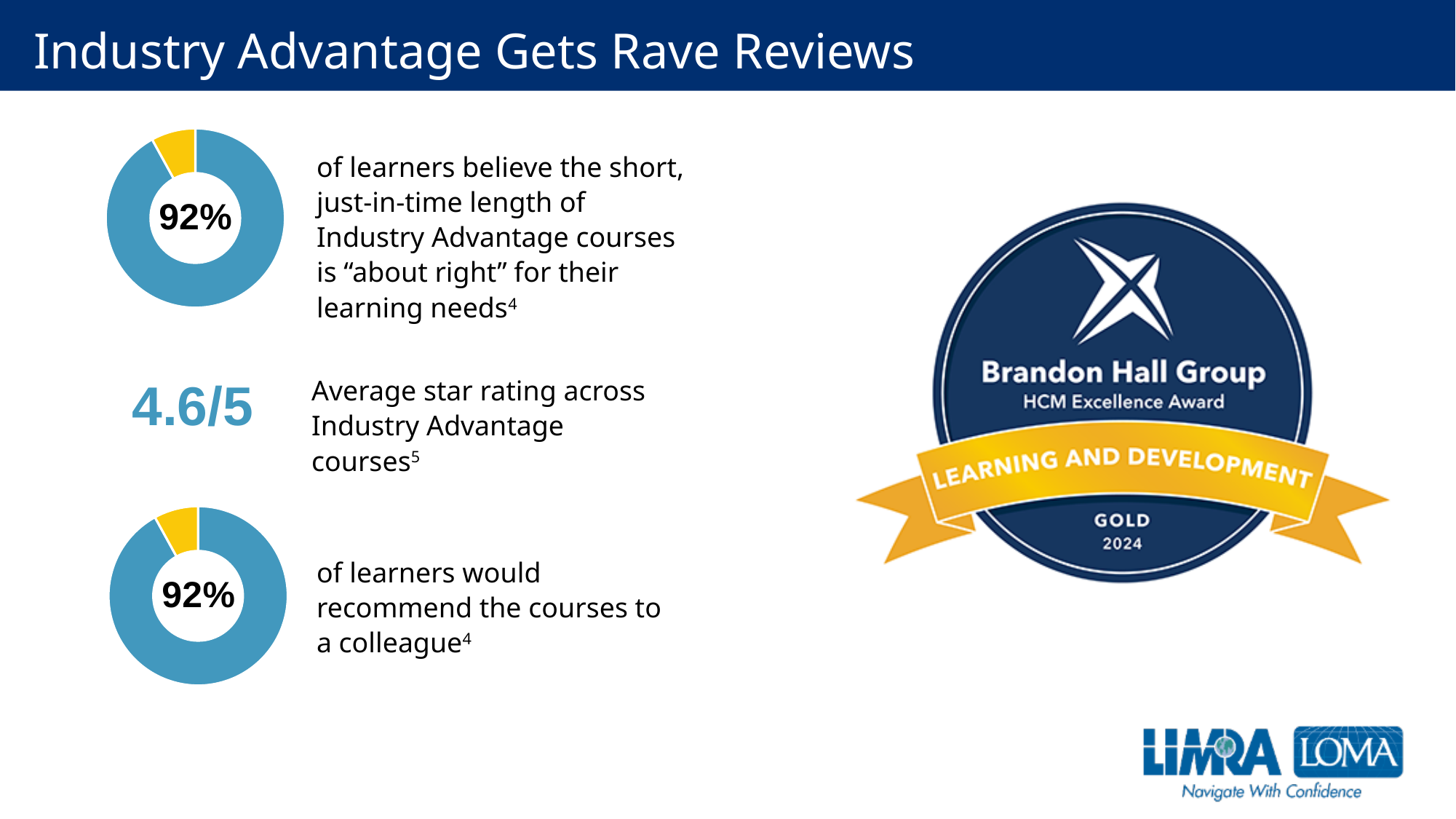
In the top donut chart, what share of the ring is not covered by the 92% blue slice? 8% In the top donut chart, how many slices does the ring contain? 2 What kind of chart is used to show the share of learners who believe the course length is "about right"? Donut (pie) chart What colour is the small remaining slice in the top donut chart? Yellow In the bottom donut chart, which slice is larger, the blue one or the yellow one? The blue one How many donut charts are shown on the slide? 2 In the bottom donut chart, what percentage of learners would recommend the courses to a colleague? 92% Is the value in the bottom donut chart higher than, lower than, or equal to the value in the top donut chart? Equal In the top donut chart, is the value shown in the centre greater or less than 50%? greater In the top donut chart, what percentage of learners believe the short, just-in-time length of Industry Advantage courses is "about right" for their learning needs? 92% What kind of chart is used to show the 92% of learners who would recommend the courses to a colleague? Donut (pie) chart What colour is the large slice representing 92% in the bottom donut chart? Blue